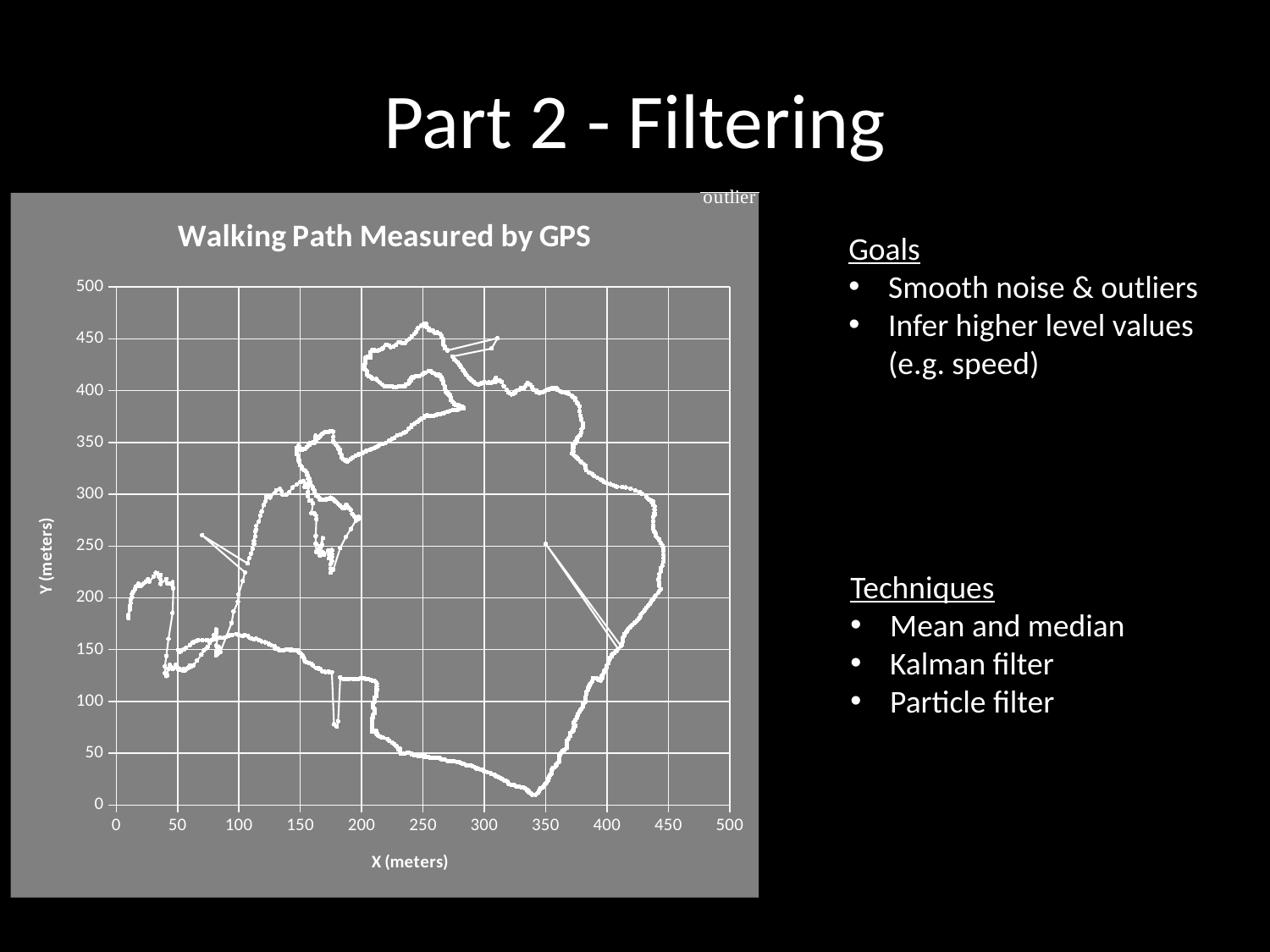
Is the lowest Y value reached by the walking path greater or less than 50? less Is the smallest X value reached by the walking path greater or less than 50? less What is the title of the chart? Walking Path Measured by GPS Does the walking path ever reach a Y value greater than 500? No What kind of chart is shown on the slide? scatter chart What is the label of the x axis? X (meters)